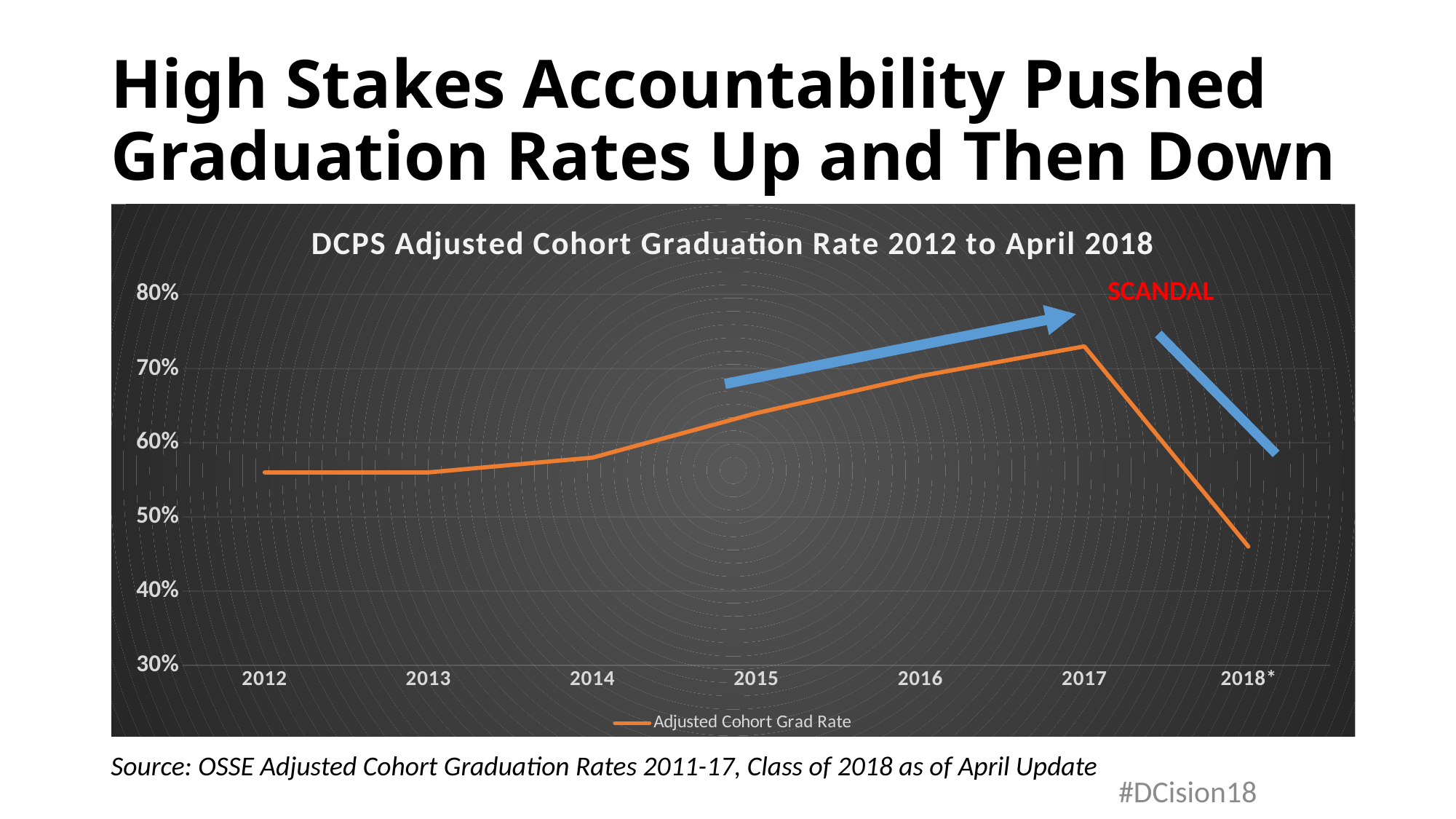
What kind of chart is shown on the slide? line chart Is the value for 2018* greater or less than 50%? less Which is larger, the value for 2016 or the value for 2014? 2016 How many series does the legend list? 1 Which year has the lowest graduation rate? 2018* How many years are plotted along the x axis? 7 Is the value for 2017 greater or less than 70%? greater Do the values rise or fall from 2012 to 2017? rise What is the title of the chart? DCPS Adjusted Cohort Graduation Rate 2012 to April 2018 Which year has the highest graduation rate? 2017 Is the value for 2012 greater or less than 60%? less